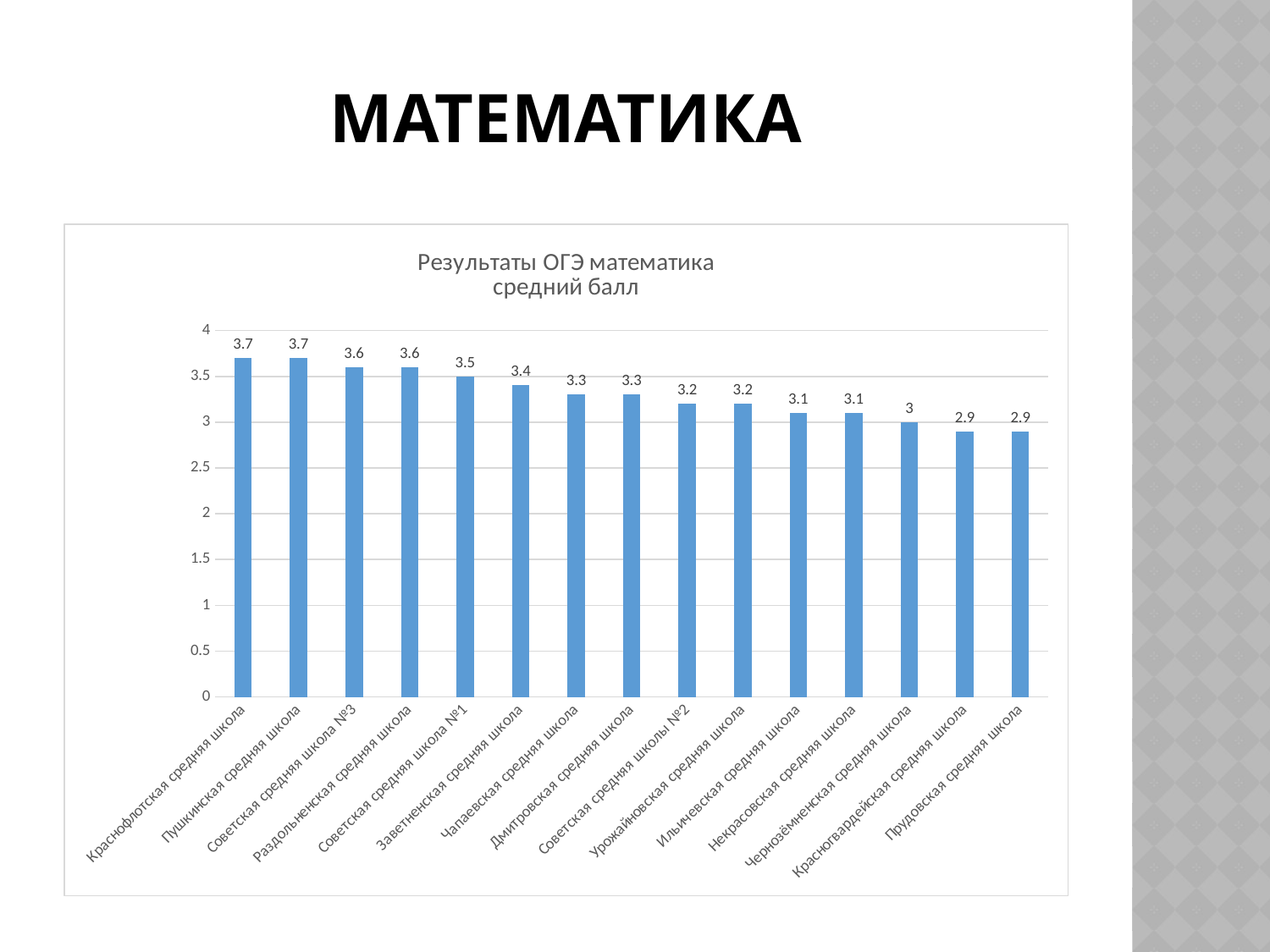
What is the difference between the scores of Советская средняя школа №3 and Ильичевская средняя школа? 0.5 What is the average score for Заветненская средняя школа? 3.4 What is the average score for Советская средняя школа №1? 3.5 What is the title of the chart? Результаты ОГЭ математика средний балл How many schools are shown in the chart? 15 What is the difference between the scores of Краснофлотская средняя школа and Красногвардейская средняя школа? 0.8 What is the average score for Чернозёмненская средняя школа? 3 What is the average score for Прудовская средняя школа? 2.9 Do the scores rise or fall from left to right across the chart? Fall Which has a higher score, Пушкинская средняя школа or Урожайновская средняя школа? Пушкинская средняя школа Which has a lower score, Чапаевская средняя школа or Некрасовская средняя школа? Некрасовская средняя школа What kind of chart is shown on the slide? Bar chart